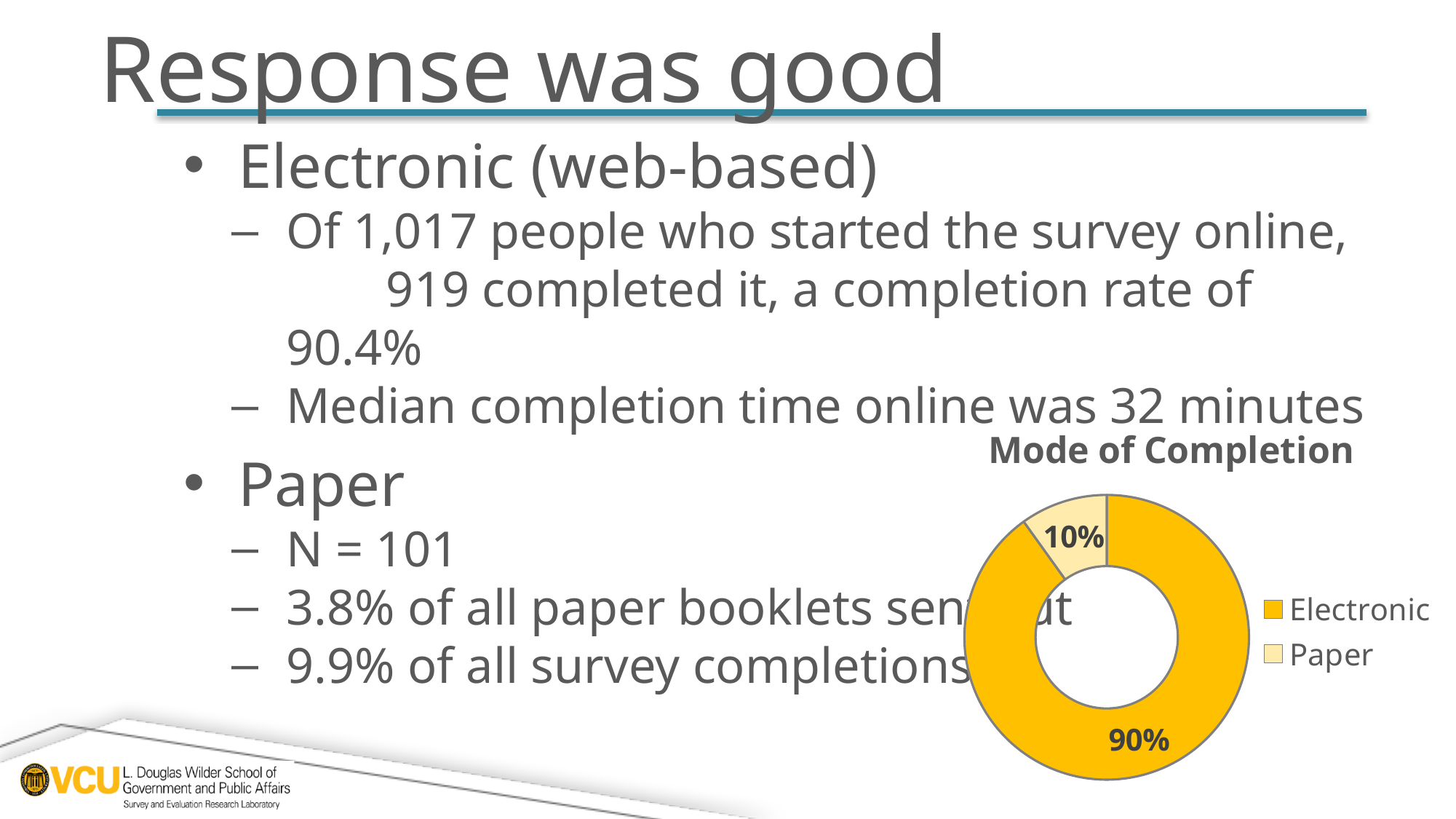
What share of the Mode of Completion chart is Paper? 10% Which is larger in the chart, the Electronic share or the Paper share? Electronic What is the title of the chart on the slide? Mode of Completion How many entries does the chart legend list? 2 Which mode of completion has the largest share in the chart? Electronic What is the difference in percentage points between the Electronic and Paper shares? 80 What kind of chart is used to show Mode of Completion? Doughnut (pie) chart How many categories does the Mode of Completion chart show? 2 What colour represents Electronic in the chart? Dark yellow (gold) What share of the Mode of Completion chart is Electronic? 90% Which mode of completion has the smallest share in the chart? Paper